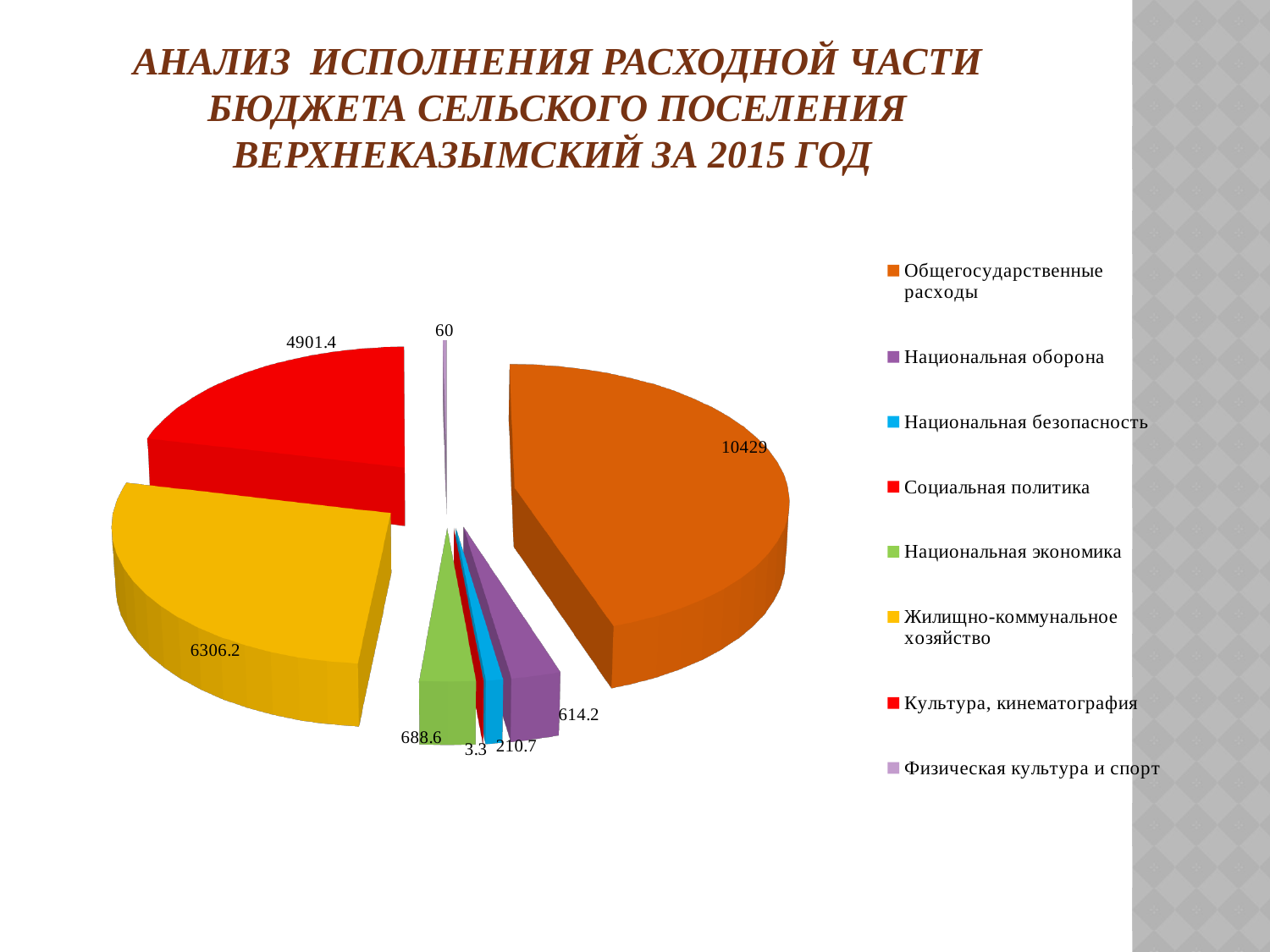
What is the smallest value labelled on the pie chart? 3.3 What is the value for Физическая культура и спорт? 60 What is the value for Общегосударственные расходы? 10429 Which category has the largest slice of the pie? Общегосударственные расходы What is the value for Национальная оборона? 614.2 What is the value for Национальная экономика? 688.6 What is the value for Жилищно-коммунальное хозяйство? 6306.2 What kind of chart is shown on the slide? pie chart Which is larger, the value for Национальная экономика or the value for Национальная оборона? Национальная экономика What is the difference between the values for Общегосударственные расходы and Жилищно-коммунальное хозяйство? 4122.8 What is the value for Национальная безопасность? 210.7 How many slices does the pie chart have? 8